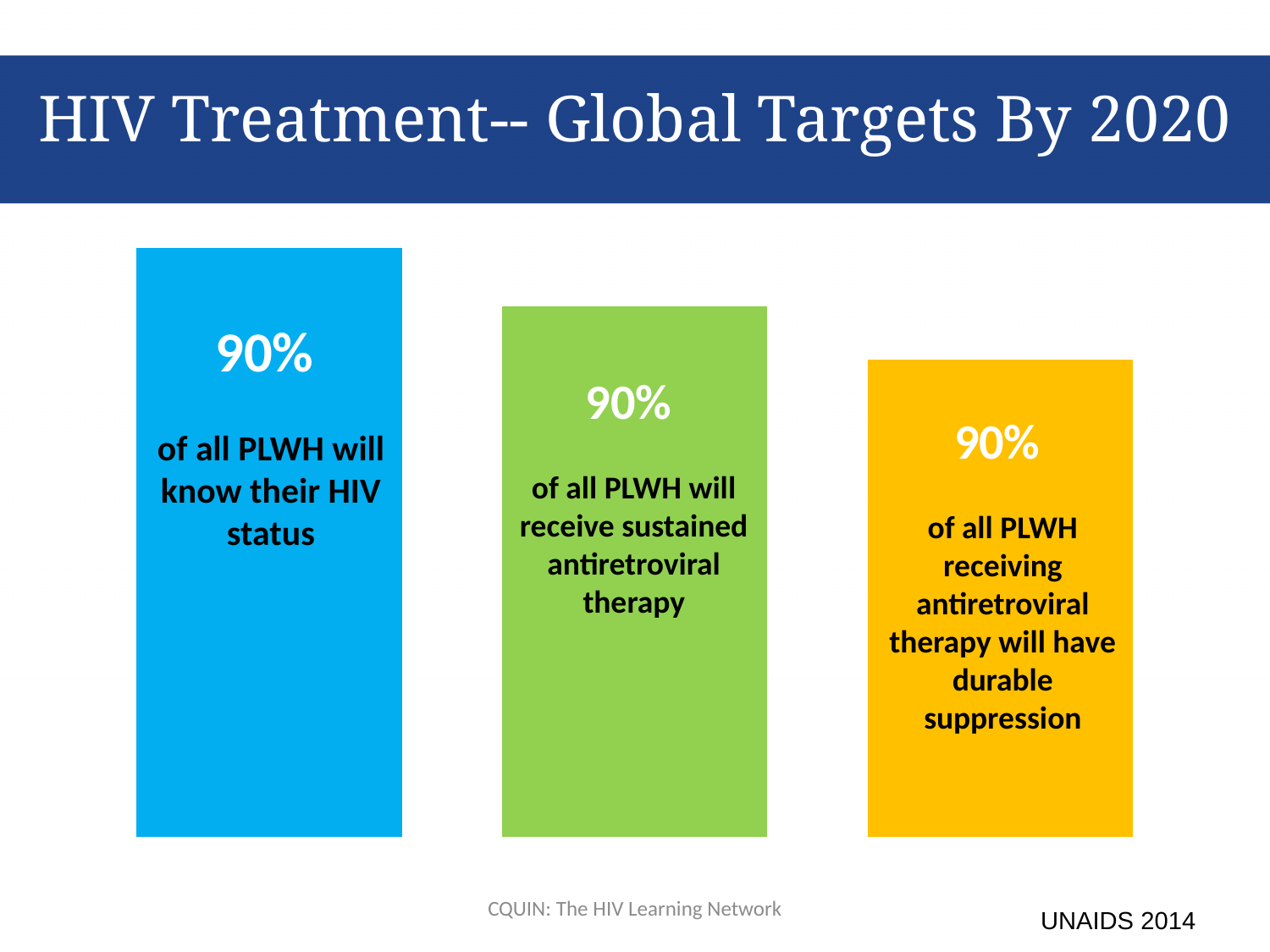
What kind of chart is used to present the global targets? bar chart What is the title of the slide? HIV Treatment-- Global Targets By 2020 What is the source cited for the targets on the slide? UNAIDS 2014 What is the target value shown for the share of all PLWH receiving antiretroviral therapy who will have durable suppression? 90% What is the target value shown for the share of all PLWH who will receive sustained antiretroviral therapy? 90% What colour is the bar for PLWH who will know their HIV status? blue What is the target value shown for the share of all PLWH who will know their HIV status? 90% How many target bars are shown on the slide? 3 Is the target value for PLWH receiving sustained antiretroviral therapy greater or less than 50%? greater